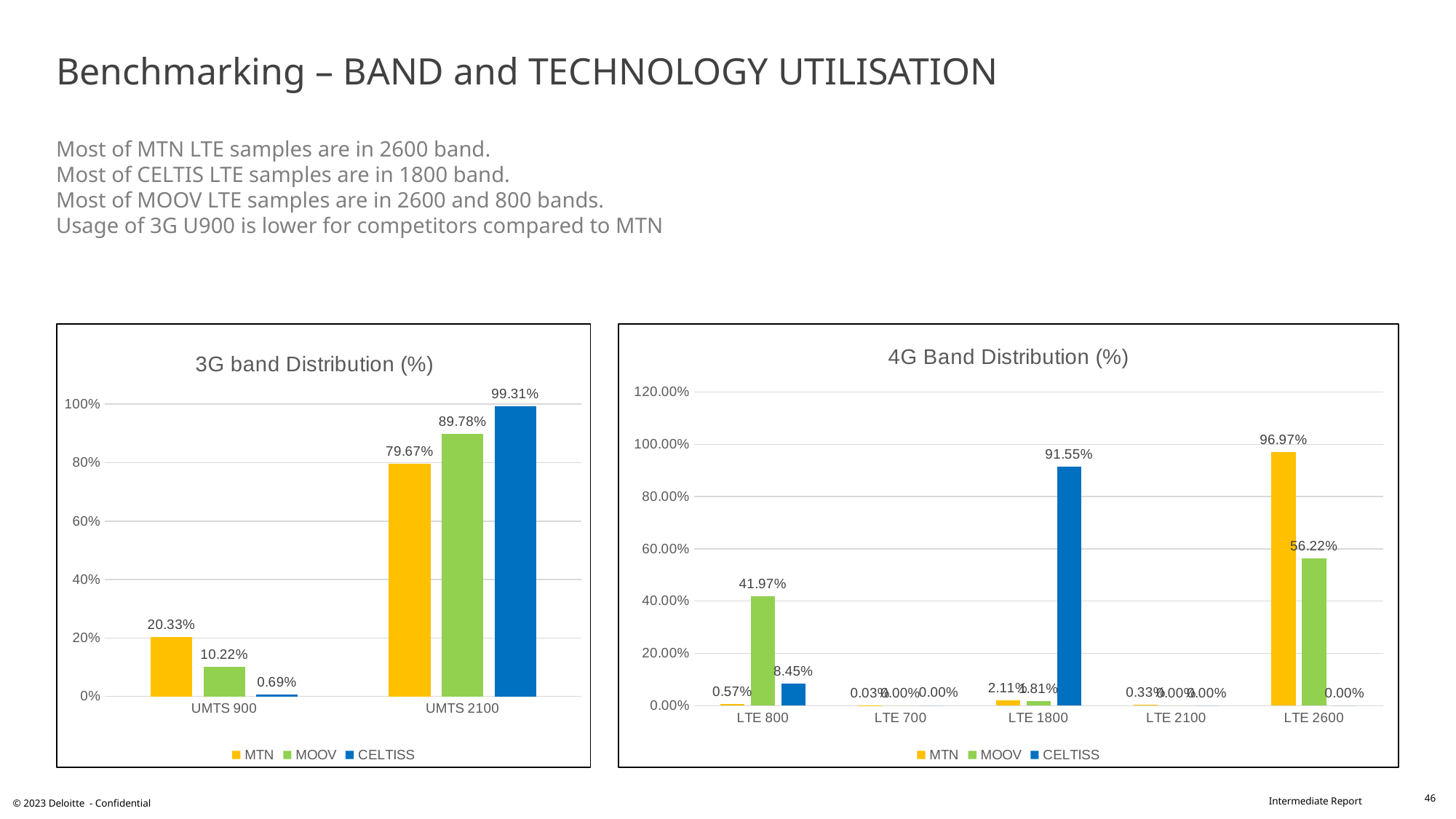
In the 4G Band Distribution (%) chart, is the value for MOOV in LTE 2600 greater or less than 60.00%? less In the 4G Band Distribution (%) chart, what is the value for MOOV in LTE 800? 41.97% In the 3G band Distribution (%) chart, how many series does the legend list? 3 In the 3G band Distribution (%) chart, which series has the lowest value in UMTS 900? CELTISS In the 3G band Distribution (%) chart, what is the value for CELTISS in UMTS 2100? 99.31% In the 4G Band Distribution (%) chart, which series has the highest value in LTE 2600? MTN In the 3G band Distribution (%) chart, what is the difference between the CELTISS and MTN values in UMTS 2100? 19.64% In the 4G Band Distribution (%) chart, what is the value for CELTISS in LTE 1800? 91.55% What kind of chart is the 3G band Distribution (%) chart? Bar chart In the 3G band Distribution (%) chart, what is the value for MTN in UMTS 900? 20.33% In the 4G Band Distribution (%) chart, what is the difference between the MTN and MOOV values in LTE 2600? 40.75% In the 4G Band Distribution (%) chart, how many band categories are shown on the x axis? 5